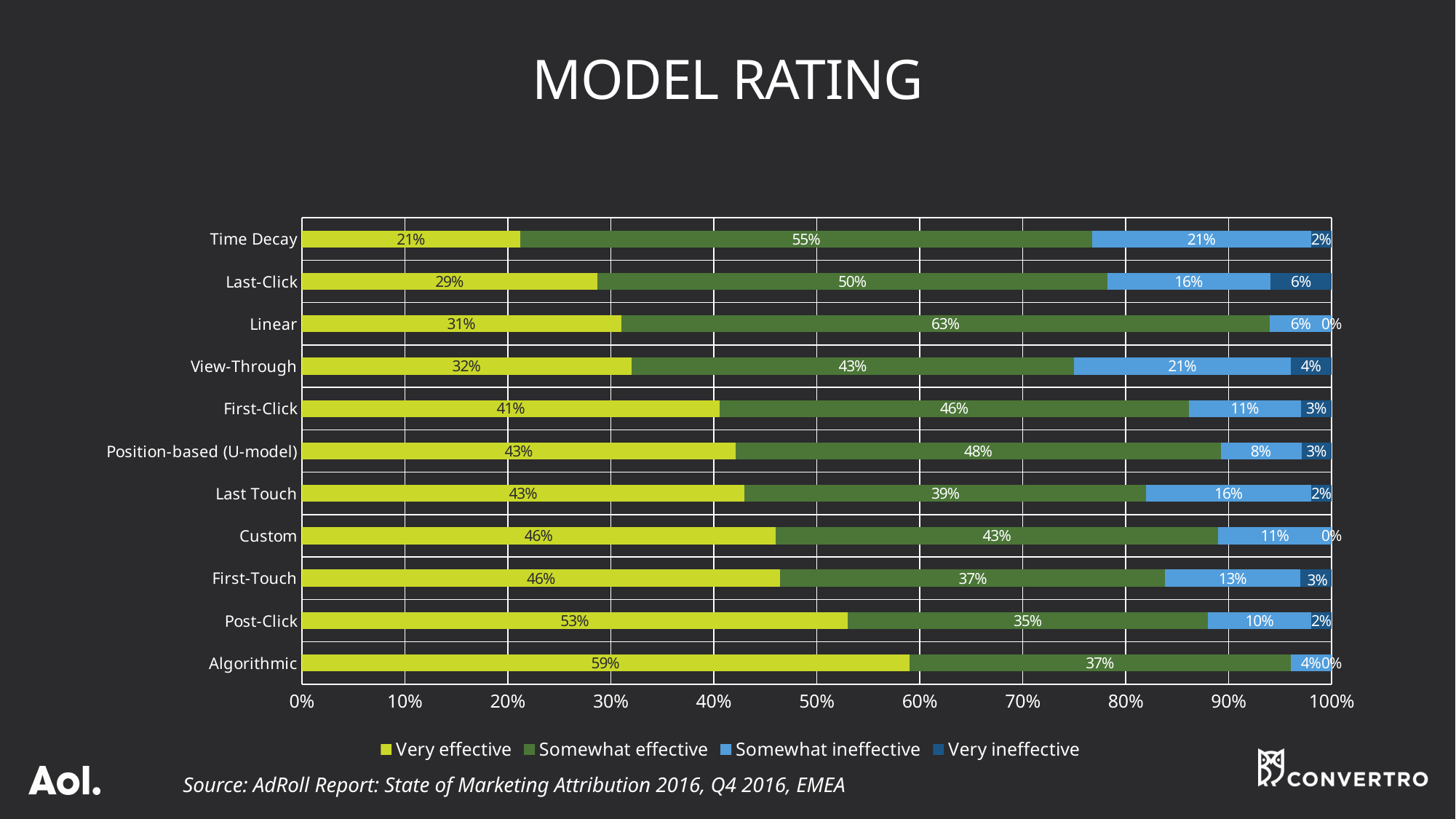
What is the difference between the Very effective values for Post-Click and Time Decay? 32% Which has a larger Somewhat effective value, Time Decay or Last Touch? Time Decay What is the Somewhat effective value for the Linear model? 63% What is the total of the labelled segments for the Time Decay bar? 99% How many models are listed on the chart? 11 Which model has the highest Very effective percentage? Algorithmic What is the Very ineffective value for Last-Click? 6% Which model has the lowest Very effective percentage? Time Decay What kind of chart is shown on the slide? Stacked bar chart How many series does the legend list? 4 What percentage of respondents rated the Algorithmic model as Very effective? 59% What is the Somewhat ineffective value for View-Through? 21%